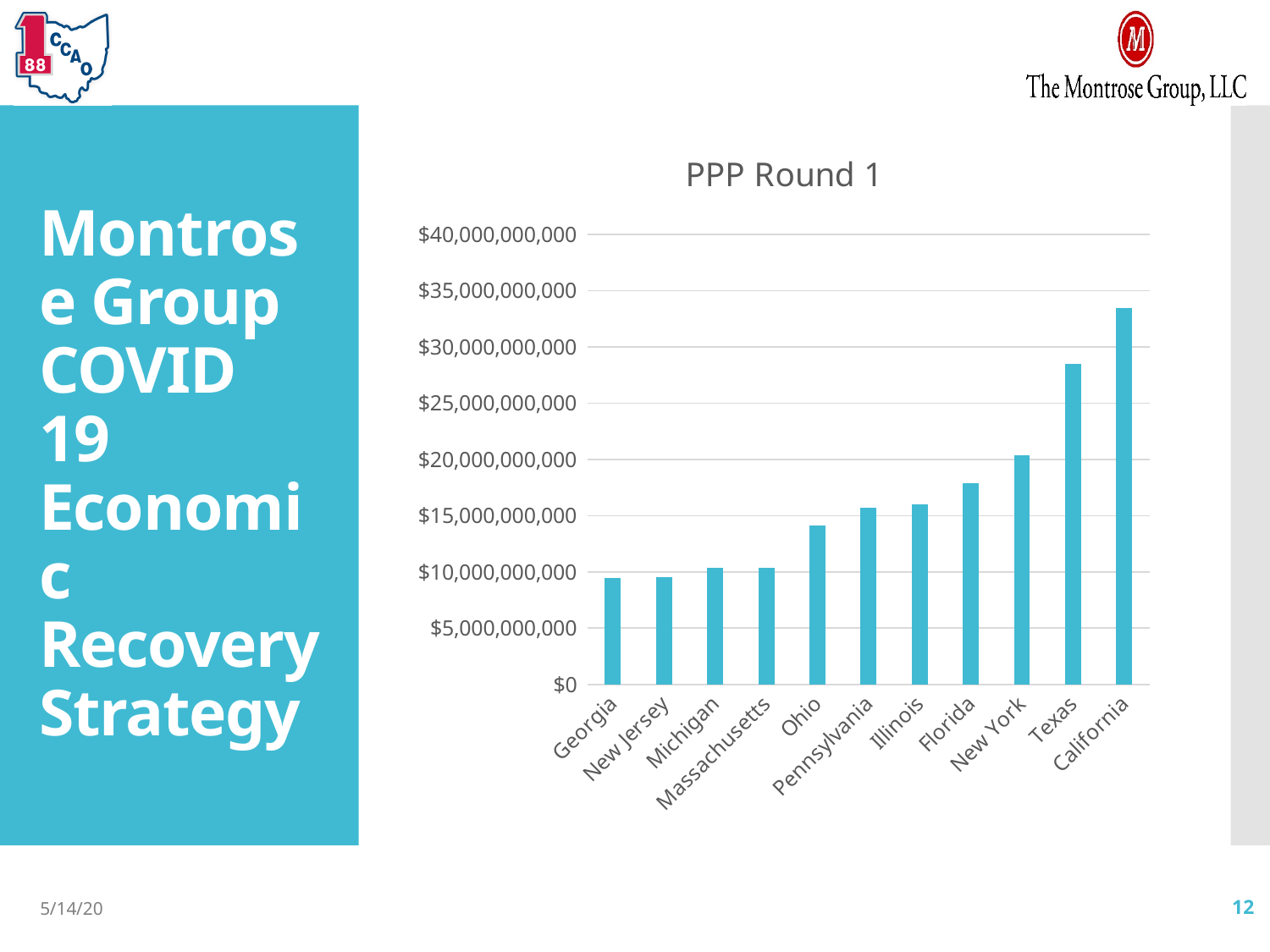
Which state has the highest value in the chart? California Which has a larger value, Texas or New York? Texas Is the value for Ohio greater or less than $15,000,000,000? less Is the value for Texas greater or less than $25,000,000,000? greater Do the values generally rise or fall moving from left to right along the x axis? rise Is the value for California greater or less than $30,000,000,000? greater Which has a larger value, Florida or Pennsylvania? Florida What kind of chart is shown on the slide? bar chart What is the title of the chart? PPP Round 1 How many states are shown on the x axis of the chart? 11